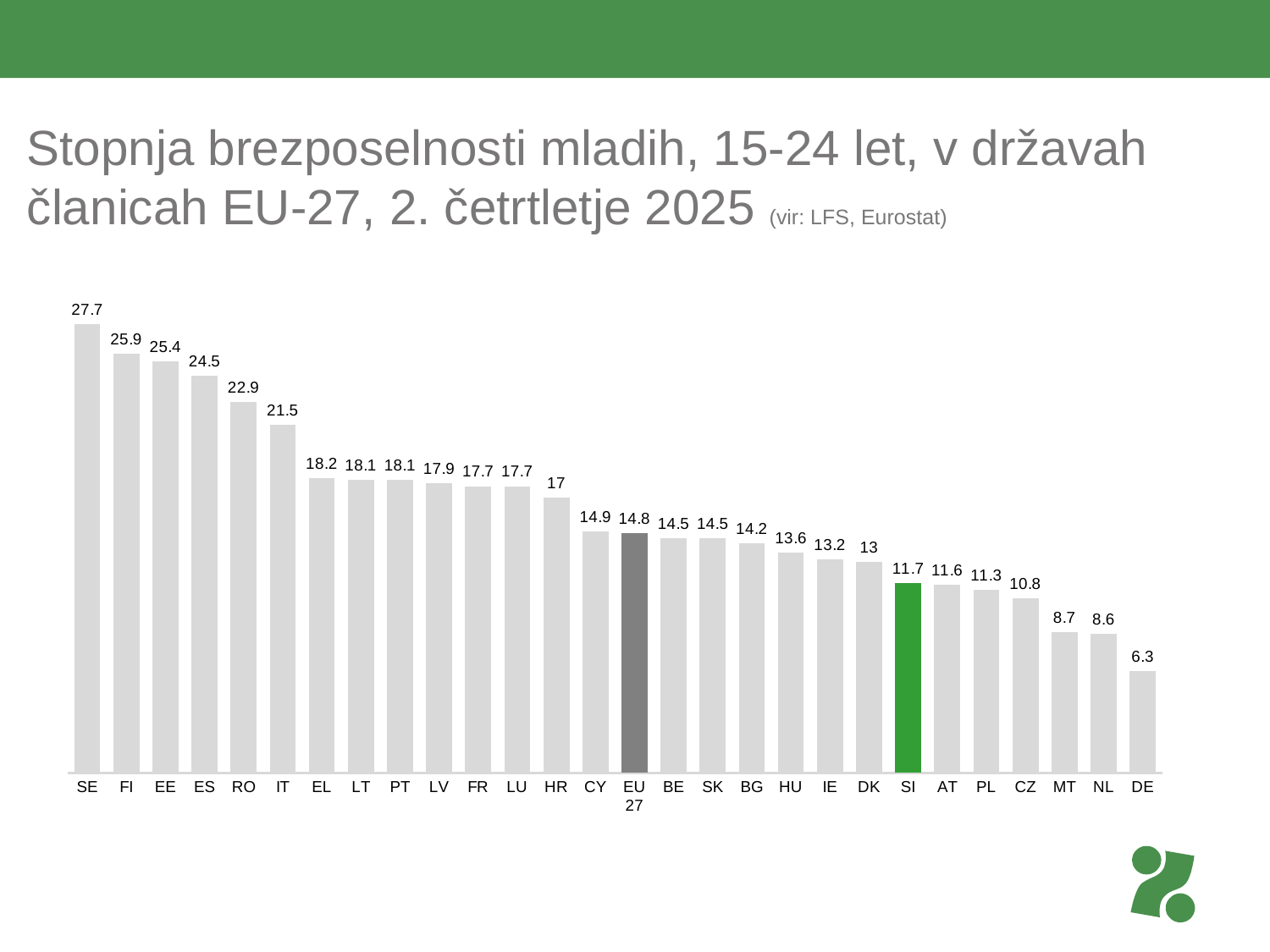
Which country has the lowest value? DE What is the value for SI? 11.7 What is the value for EU 27? 14.8 How many bars are shown in the chart? 28 Which has a larger value, ES or IT? ES What kind of chart is shown on the slide? bar chart What is the value for HR? 17 Which country has the highest value? SE Which bar is coloured green? SI What is the difference between the values for EU 27 and SI? 3.1 Do the values rise or fall from left to right along the x axis? fall What is the difference between the values for SE and DE? 21.4